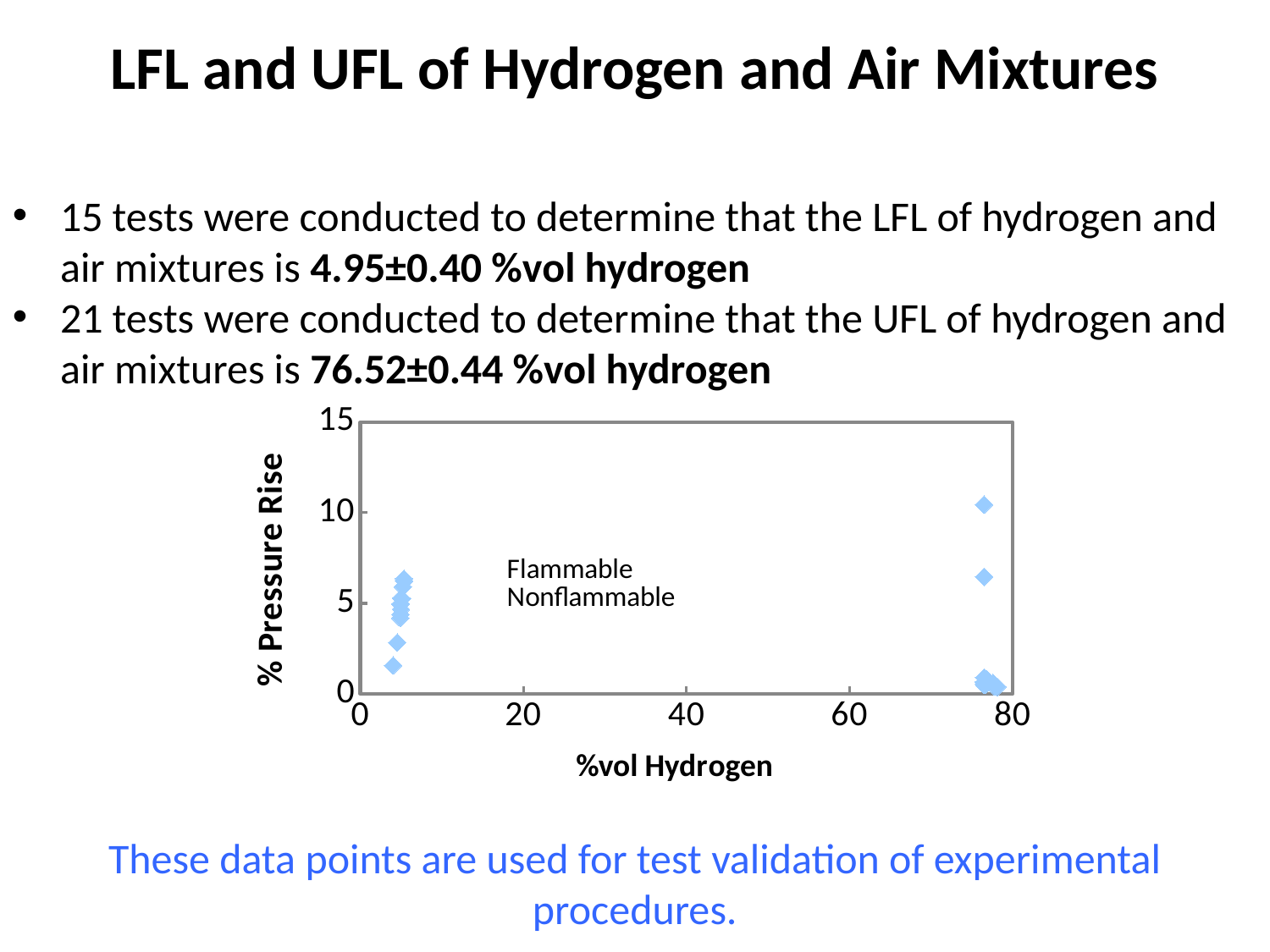
Are the data points in the left-hand cluster greater or less than 20 on the %vol Hydrogen axis? less Are the data points plotted near 5 %vol hydrogen greater or less than 10 on the % Pressure Rise axis? less What is the title of the y axis of the chart? % Pressure Rise Are the data points in the right-hand cluster greater or less than 60 on the %vol Hydrogen axis? greater Is the highest point in the left-hand cluster (near 5 %vol hydrogen) higher or lower than the highest point in the right-hand cluster (near 77 %vol hydrogen)? lower What is the title of the x axis of the chart? %vol Hydrogen What kind of chart is shown on the slide? scatter chart Which cluster contains the data point with the highest % Pressure Rise: the cluster near 5 %vol hydrogen or the cluster near 77 %vol hydrogen? the cluster near 77 %vol hydrogen How many distinct clusters of data points are plotted on the chart? 2